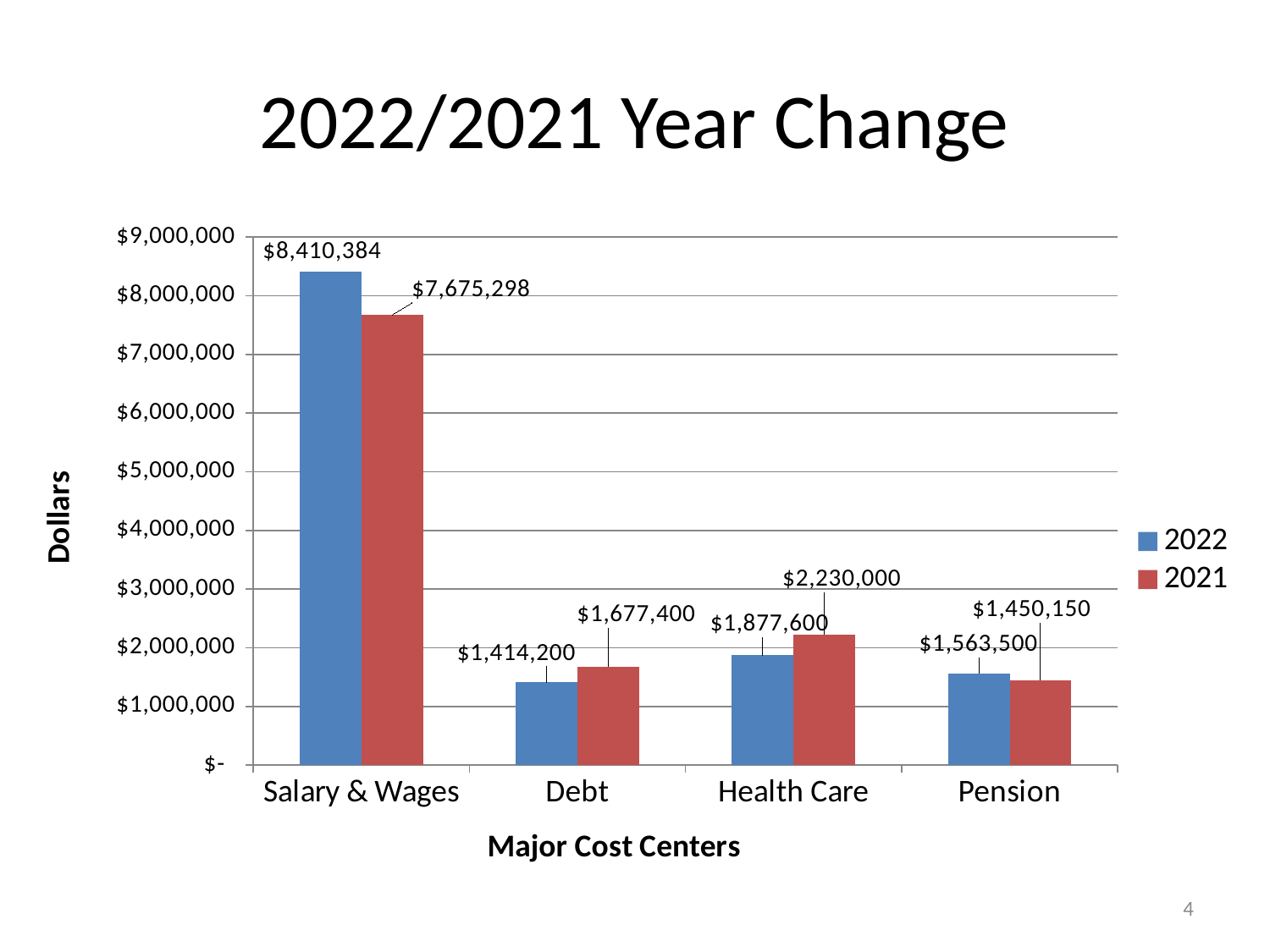
What is the 2022 value for Pension? $1,563,500 What is the difference between the 2021 and 2022 values for Health Care? $352,400 How many series does the legend list? 2 What is the 2021 value for Debt? $1,677,400 Which cost center has the lowest 2021 value? Pension What is the 2022 value for Salary & Wages? $8,410,384 What type of chart is shown on the slide? Bar chart For Debt, which year has the larger value, 2022 or 2021? 2021 What is the difference between the 2022 and 2021 values for Salary & Wages? $735,086 What is the 2021 value for Health Care? $2,230,000 Which cost center has the highest 2022 value? Salary & Wages How many cost centers are shown on the x axis? 4